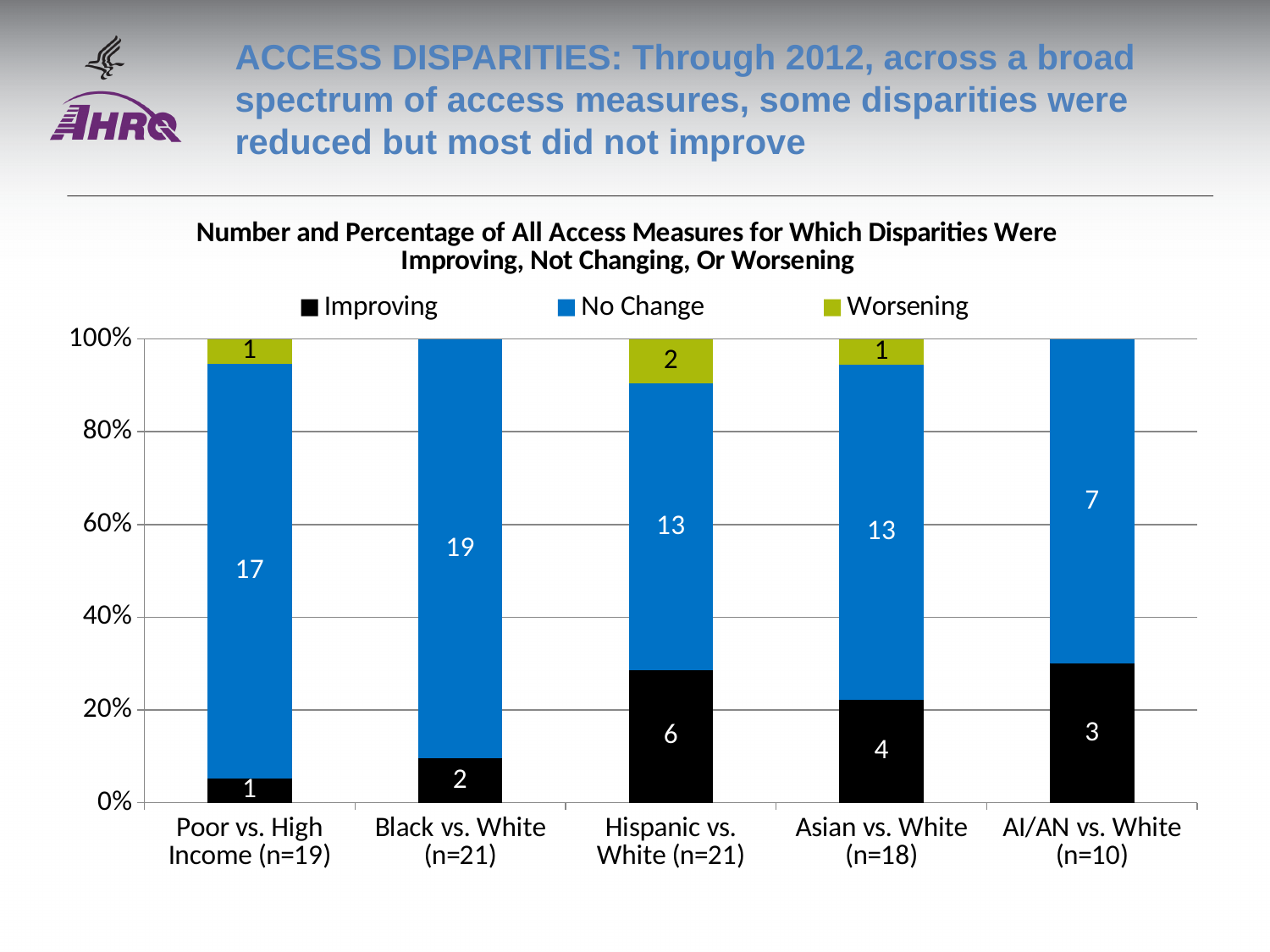
What is the No Change value for Black vs. White (n=21)? 19 What is the difference between the No Change values for Poor vs. High Income (n=19) and AI/AN vs. White (n=10)? 10 How many series does the legend list? 3 How many categories are shown on the x axis? 5 What kind of chart is shown on the slide? Stacked bar chart Is the No Change share of the bar for Poor vs. High Income (n=19) greater or less than 80%? greater What is the Improving value for Hispanic vs. White (n=21)? 6 Which category has the lowest No Change value? AI/AN vs. White (n=10) Which category has the highest Improving value? Hispanic vs. White (n=21) What is the Worsening value for Hispanic vs. White (n=21)? 2 Which is larger, the Improving value for Asian vs. White (n=18) or for Black vs. White (n=21)? Asian vs. White (n=18) What is the Improving value for AI/AN vs. White (n=10)? 3